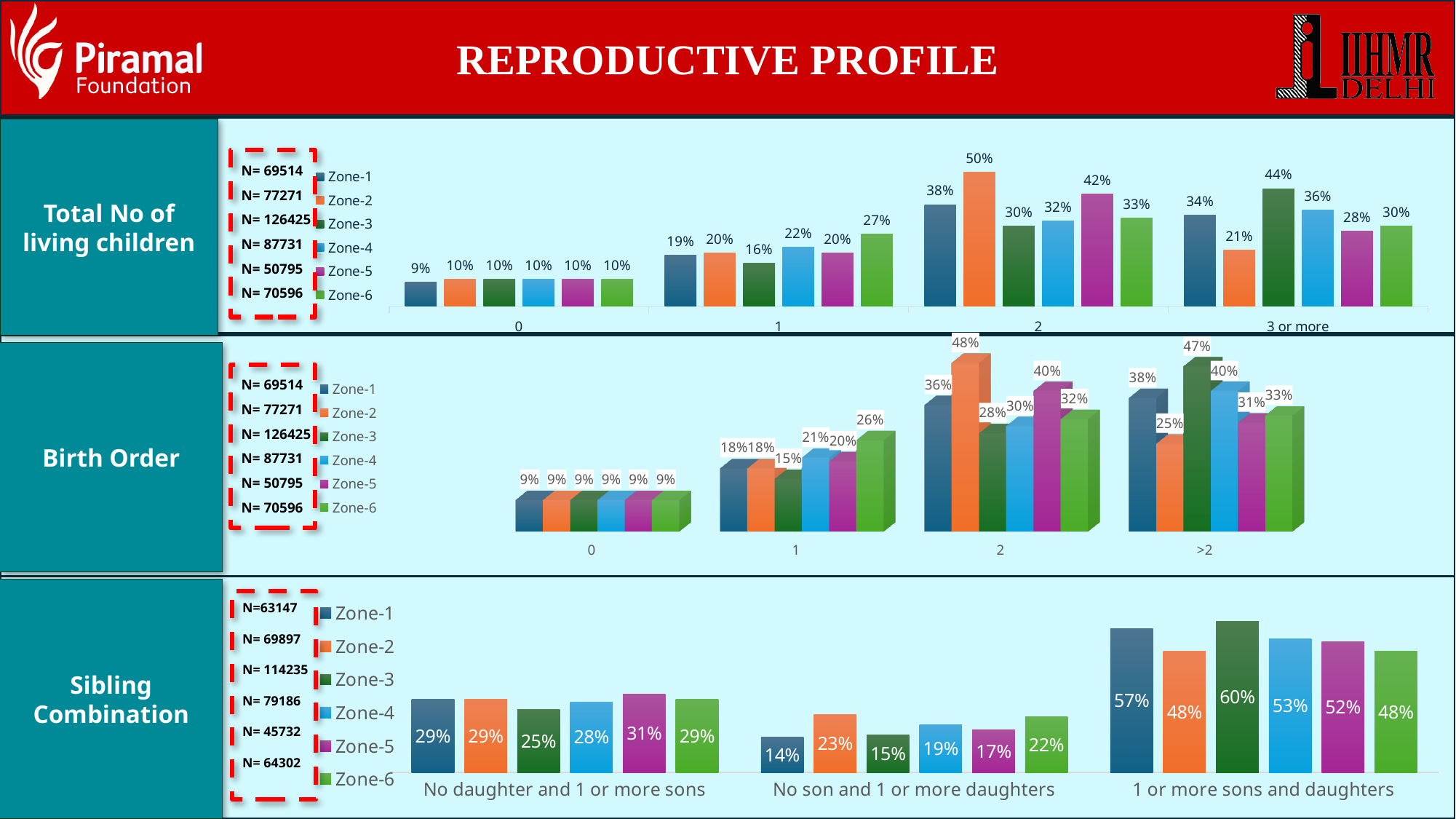
What kind of chart is the 'Sibling Combination' chart? bar chart In the 'Birth Order' chart, is the value for Zone-2 in the '2' category larger or smaller than the value for Zone-1 in the same category? larger In the 'Total No of living children' chart, what is the difference between Zone-6 and Zone-1 in the '1' category? 8% In the 'Sibling Combination' chart, what is the value for Zone-3 in the '1 or more sons and daughters' category? 60% In the 'Sibling Combination' chart, which zone has the lowest value in the 'No son and 1 or more daughters' category? Zone-1 In the 'Sibling Combination' chart, what is the difference between Zone-5 and Zone-3 in the 'No daughter and 1 or more sons' category? 6% In the 'Birth Order' chart, how many series does the legend list? 6 In the 'Total No of living children' chart, how many categories are shown on the x axis? 4 In the 'Total No of living children' chart, which zone has the highest value in the '3 or more' category? Zone-3 In the 'Birth Order' chart, what is the value for Zone-3 in the '>2' category? 47% In the 'Birth Order' chart, which zone has the lowest value in the '2' category? Zone-3 In the 'Total No of living children' chart, what is the value for Zone-2 in the '2' category? 50%